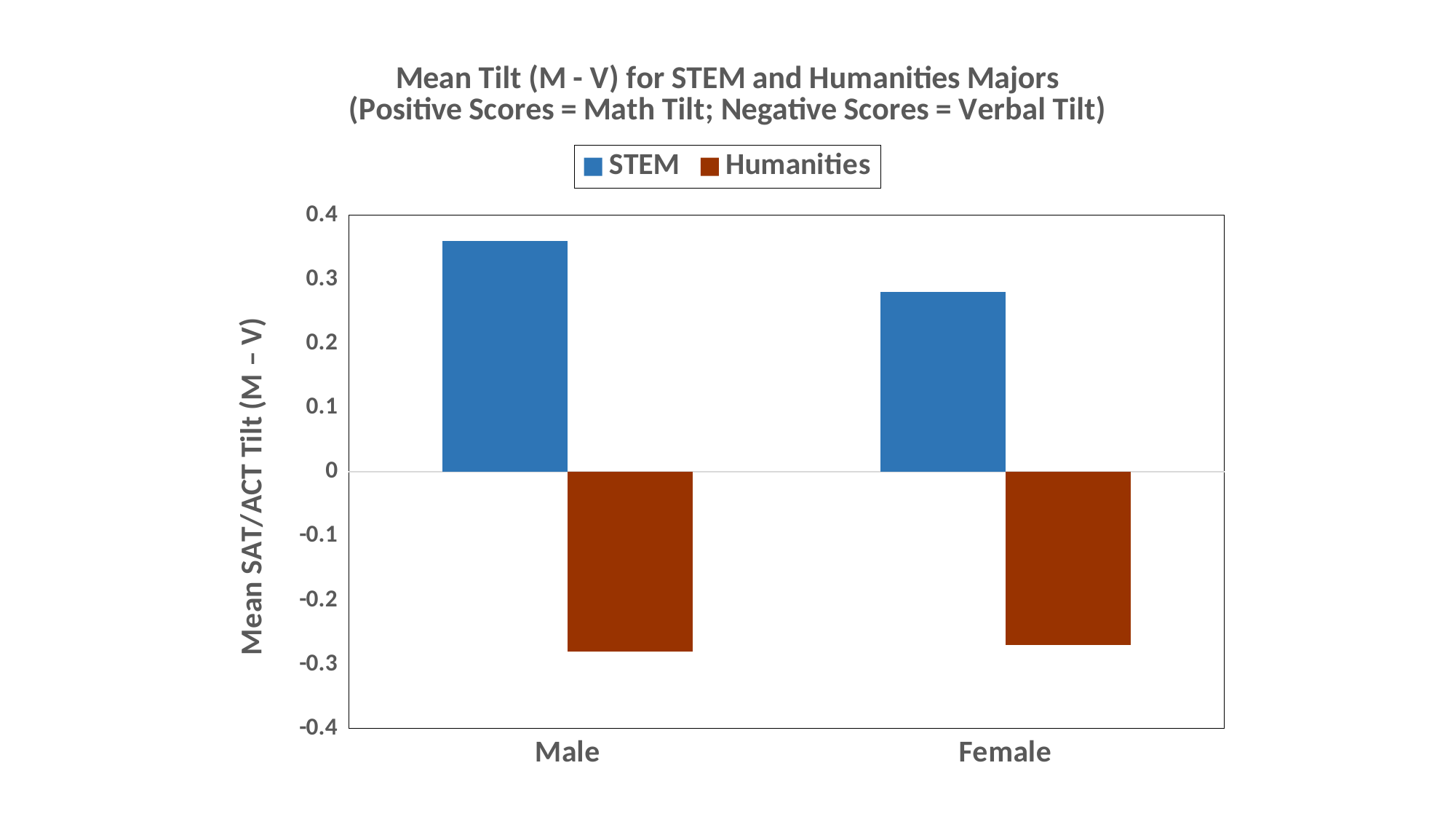
What is the label on the vertical axis? Mean SAT/ACT Tilt (M – V) Is the Humanities value for Male greater or less than -0.2? less How many series does the legend list? 2 What kind of chart is shown on the slide? bar chart Is the Humanities value for Female greater or less than -0.2? less Which series is shown in blue? STEM Which is larger, the STEM value for Male or the STEM value for Female? Male Is the STEM value for Male greater or less than 0.3? greater Which bar has the highest value on the chart? STEM for Male How many categories are shown on the x axis? 2